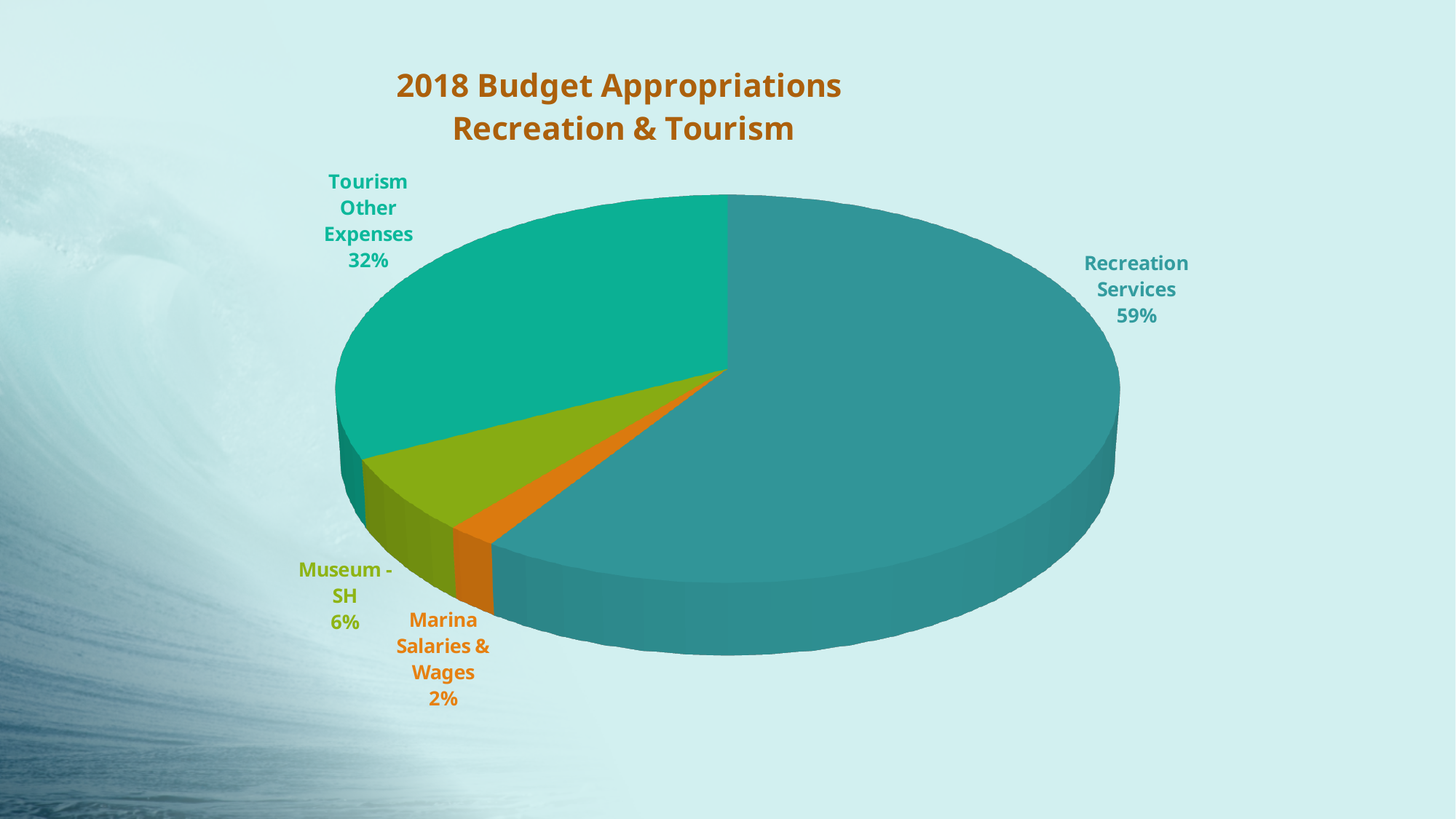
What is the difference in percentage points between Recreation Services and Tourism Other Expenses? 27 What is the difference in percentage points between Museum - SH and Marina Salaries & Wages? 4 How many slices does the pie chart have? 4 What share of the pie is Marina Salaries & Wages? 2% What kind of chart is shown on the slide? Pie chart Which category has the smallest slice of the pie? Marina Salaries & Wages Which is larger, Museum - SH or Marina Salaries & Wages? Museum - SH What share of the pie is Recreation Services? 59% What share of the pie is Tourism Other Expenses? 32% Which category has the largest slice of the pie? Recreation Services What is the title of the chart? 2018 Budget Appropriations Recreation & Tourism